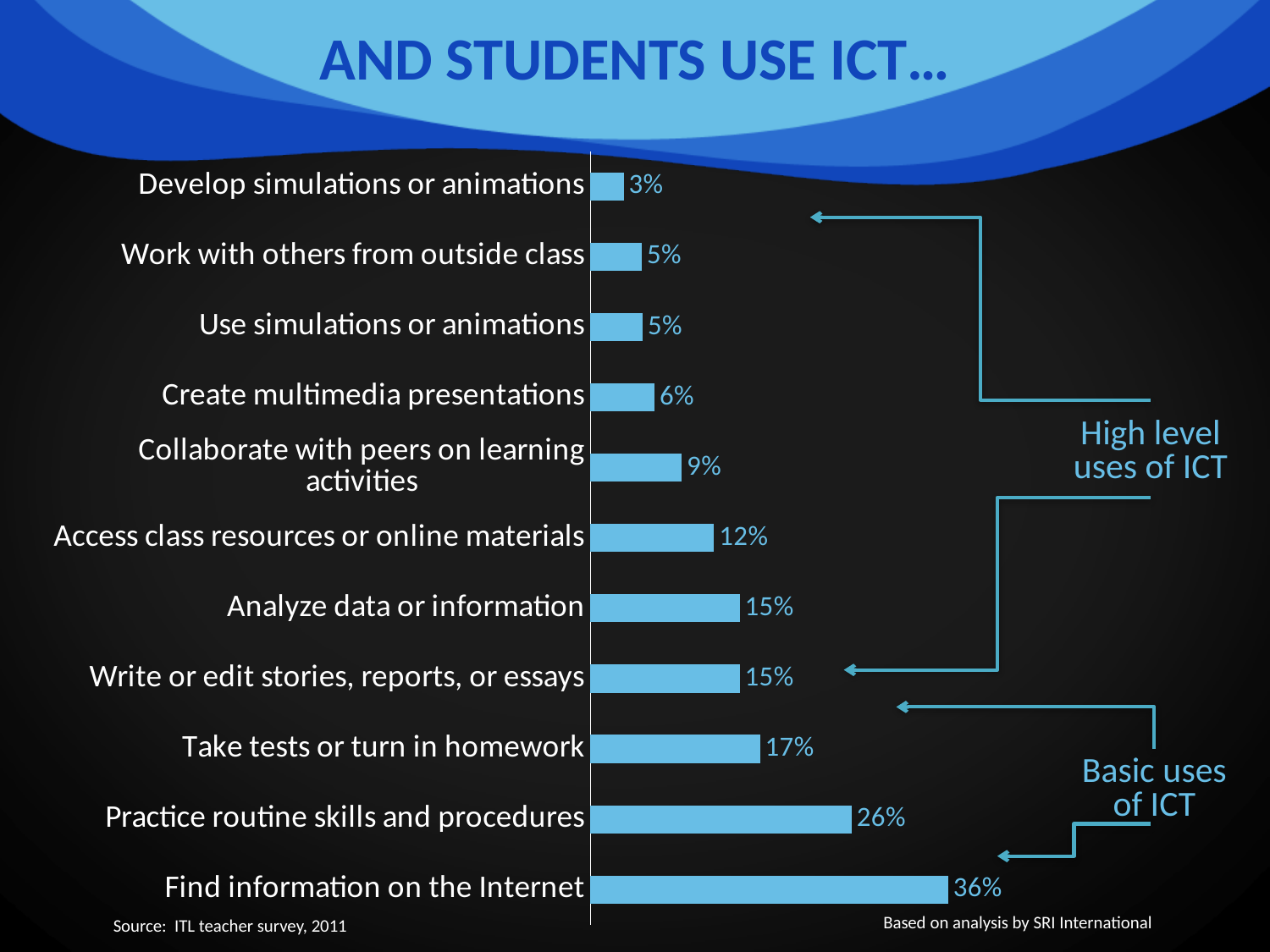
What is the difference between 'Find information on the Internet' and 'Practice routine skills and procedures'? 10% What is the difference between 'Take tests or turn in homework' and 'Access class resources or online materials'? 5% What kind of chart is shown on the slide? Bar chart What is the value for 'Collaborate with peers on learning activities'? 9% How many categories are shown in the chart? 11 What is the source cited for the chart data? ITL teacher survey, 2011 Which category has the lowest value? Develop simulations or animations What is the title of the slide? AND STUDENTS USE ICT… Which is larger: 'Create multimedia presentations' or 'Analyze data or information'? Analyze data or information What is the value for 'Practice routine skills and procedures'? 26% Which category has the highest value? Find information on the Internet What percentage of students find information on the Internet? 36%